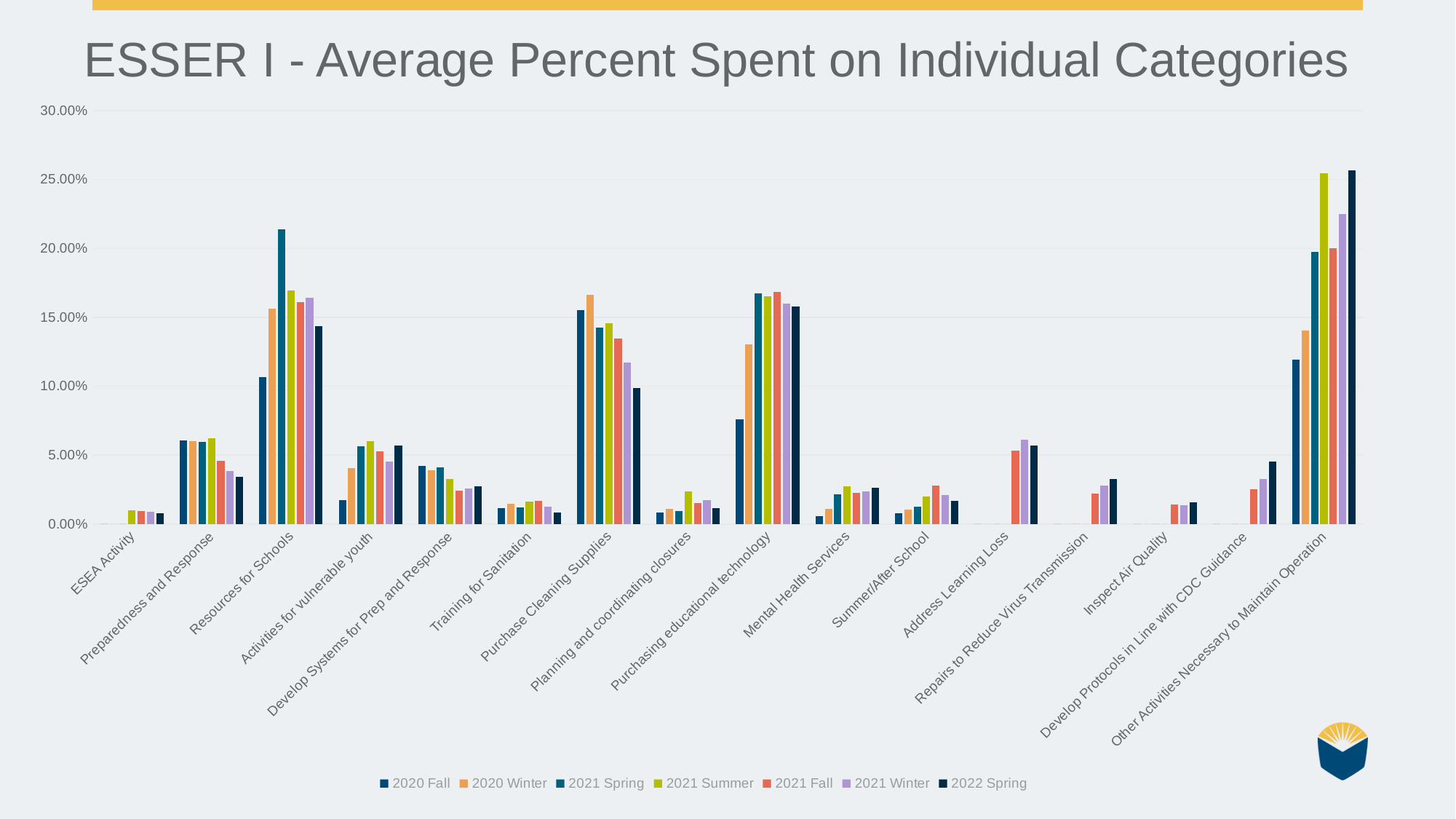
Which series has the lowest bar for Other Activities Necessary to Maintain Operation? 2020 Fall Is the 2020 Winter value for Purchase Cleaning Supplies greater or less than 15.00%? greater Which series has the tallest bar for Resources for Schools? 2021 Spring Is the 2021 Spring value for Resources for Schools greater or less than 20.00%? greater How many series does the legend list? 7 What is the title of the chart? ESSER I - Average Percent Spent on Individual Categories For Purchase Cleaning Supplies, which is larger: the 2020 Winter value or the 2022 Spring value? 2020 Winter Is the 2022 Spring value for Other Activities Necessary to Maintain Operation greater or less than 20.00%? greater What kind of chart is shown on the slide? Bar chart How many categories are shown along the x axis? 16 Which category has the highest 2021 Summer bar? Other Activities Necessary to Maintain Operation